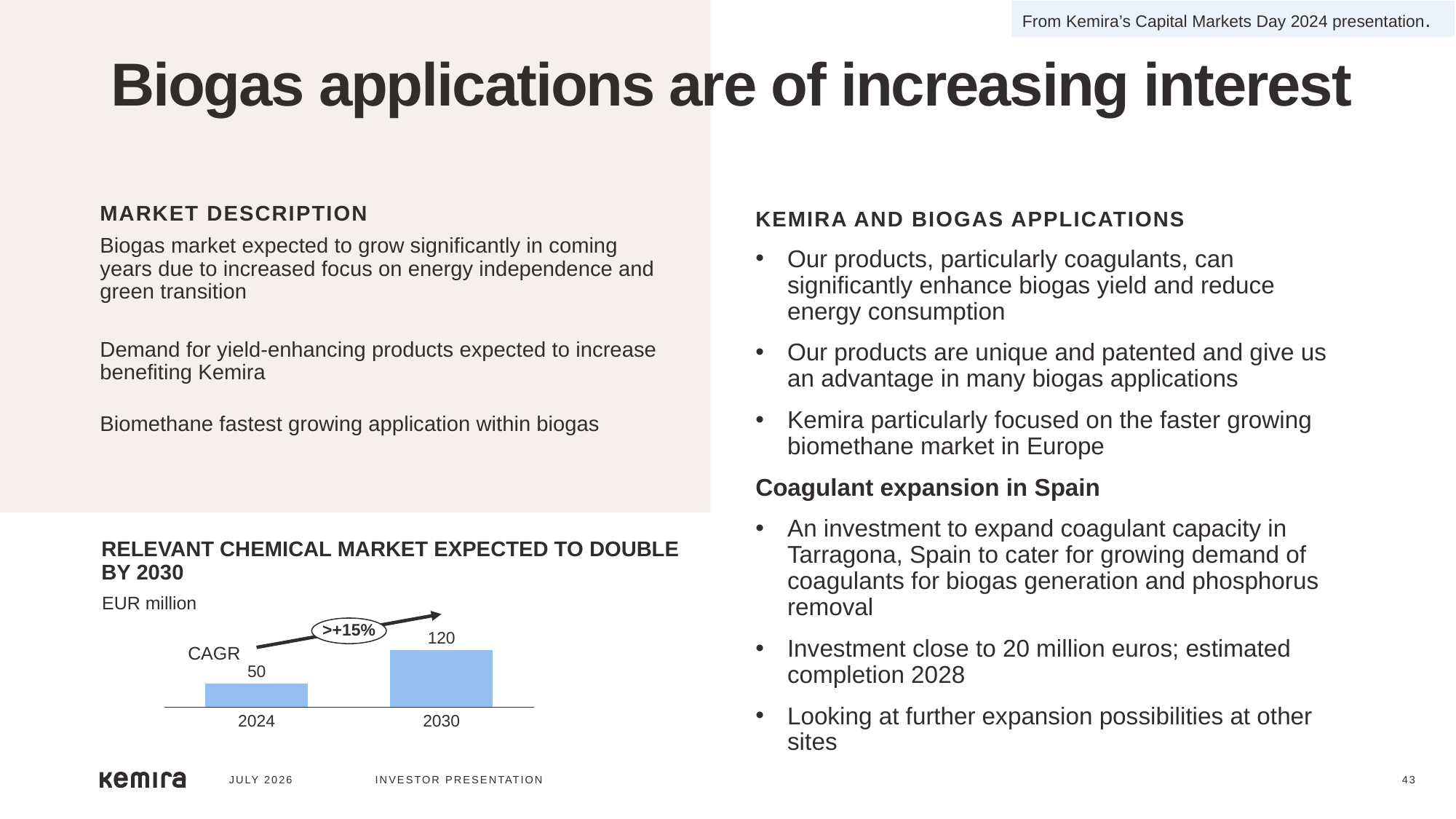
Which year has the higher value in the chart? 2030 What CAGR is shown on the chart? >+15% Is the value for 2030 larger or smaller than the value for 2024? larger Which year has the lower value in the chart? 2024 What is the difference between the 2030 and 2024 values in the chart? 70 Do the values rise or fall from 2024 to 2030? rise What is the value for 2030 in the chart? 120 What kind of chart is shown on the slide? bar chart What is the value for 2024 in the chart? 50 How many bars are shown in the chart? 2 What unit is the chart measured in? EUR million